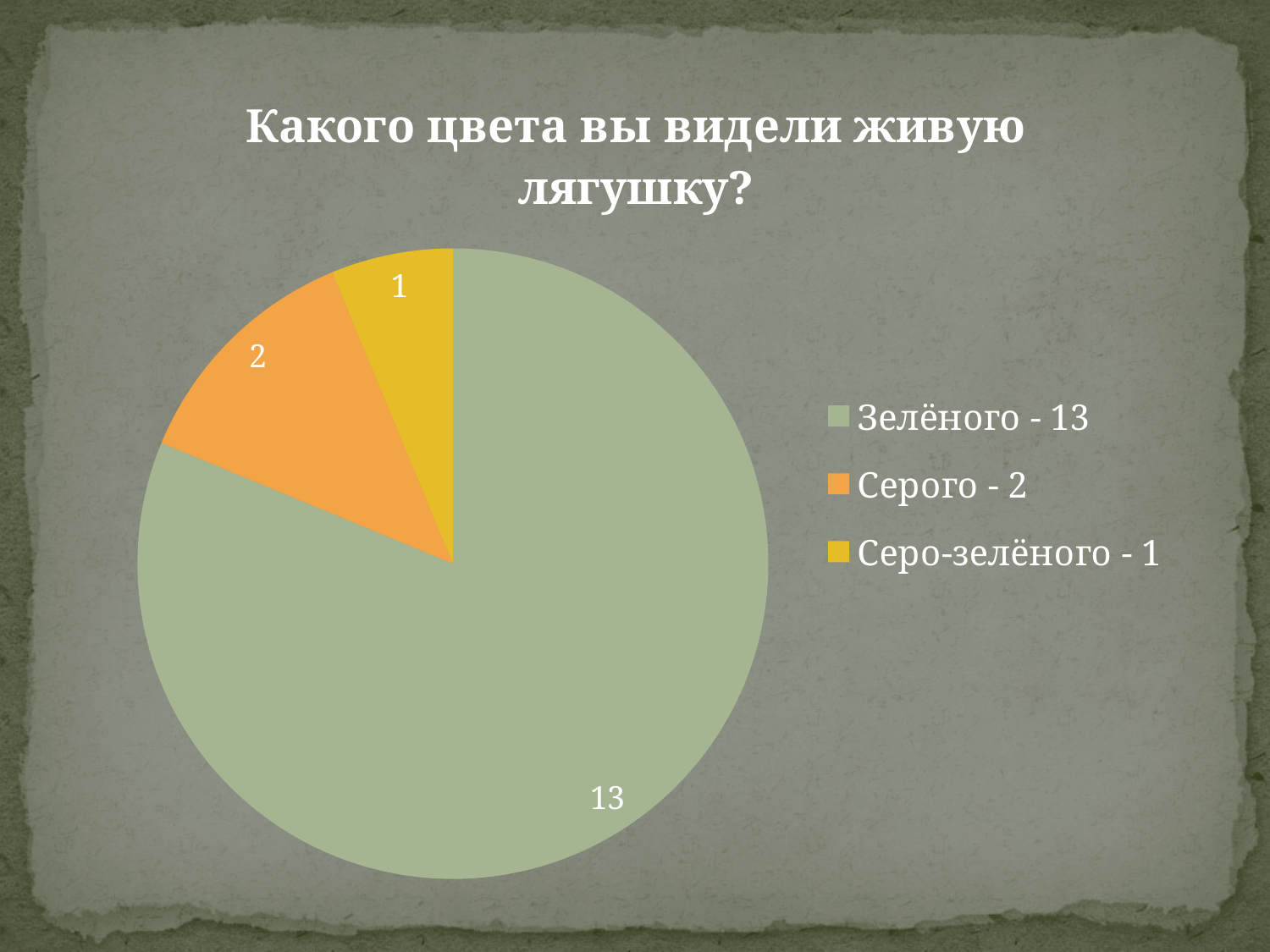
What is the title of the chart? Какого цвета вы видели живую лягушку? Which category has the largest slice? Зелёного What is the value for the slice labelled 'Серо-зелёного'? 1 What is the value for the slice labelled 'Зелёного'? 13 Which category has the smallest slice? Серо-зелёного What is the difference between the values for 'Зелёного' and 'Серого'? 11 What colour is the slice for 'Серого'? orange What is the value for the slice labelled 'Серого'? 2 What is the total of all slices in the pie chart? 16 Which is larger, the value for 'Серого' or for 'Серо-зелёного'? Серого What kind of chart is shown on the slide? pie chart How many slices does the pie chart have? 3